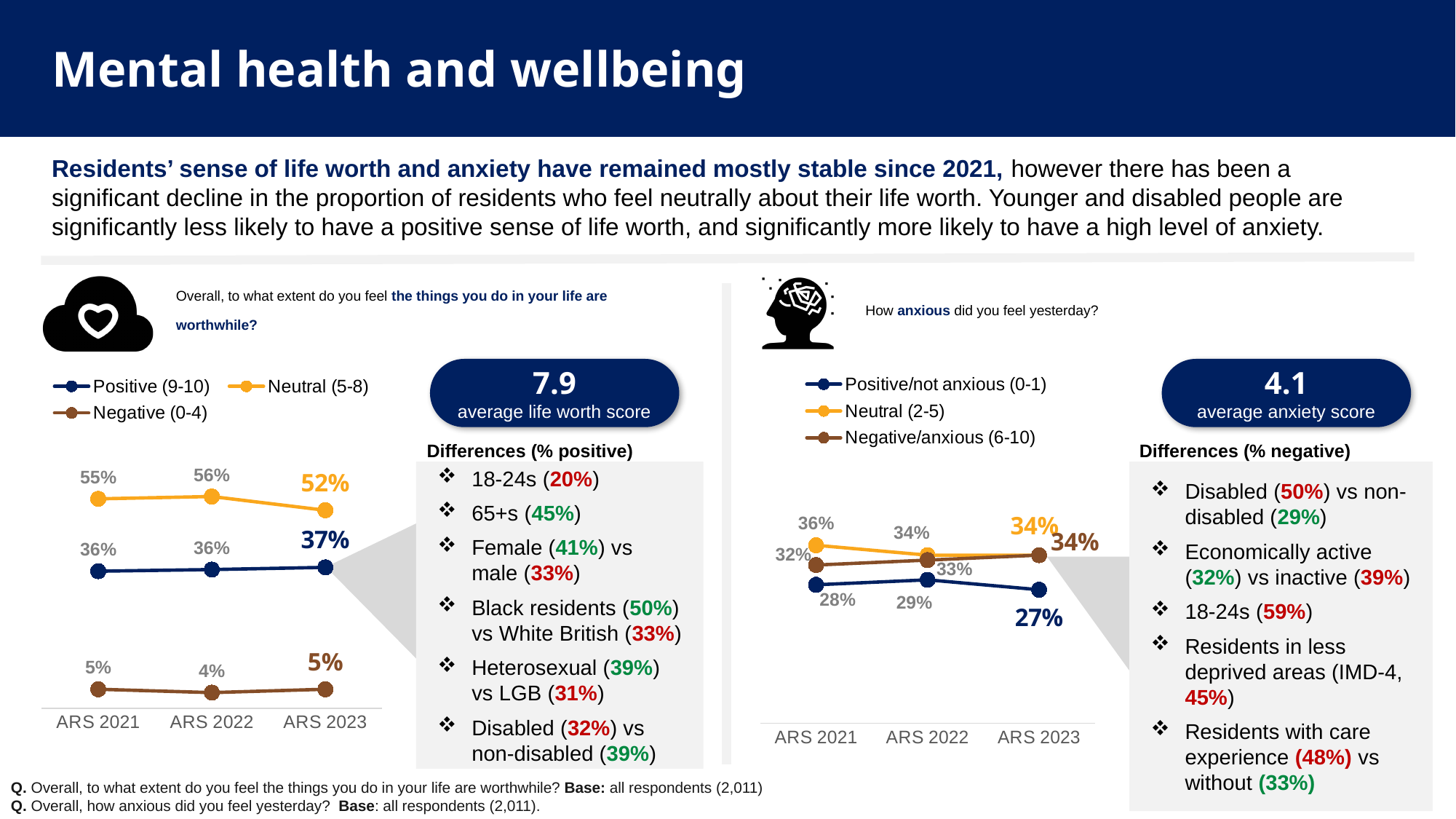
On the left chart (life worth), which series has the highest value in ARS 2023? Neutral (5-8) On the right chart (anxiety), what is the value for Negative/anxious (6-10) in ARS 2023? 34% On the left chart (life worth), what is the difference between the Neutral (5-8) and Positive (9-10) values in ARS 2023? 15 percentage points On the left chart (life worth), how many series does the legend list? 3 On the left chart (life worth), what is the value for Neutral (5-8) in ARS 2023? 52% On the left chart (life worth), what is the value for Negative (0-4) in ARS 2022? 4% On the left chart (life worth), what is the value for Positive (9-10) in ARS 2021? 36% On the left chart (life worth), what kind of chart is it? Line chart On the right chart (anxiety), what is the value for Positive/not anxious (0-1) in ARS 2021? 28% On the right chart (anxiety), how many survey years are shown on the x axis? 3 On the right chart (anxiety), which series has the lowest value in ARS 2023? Positive/not anxious (0-1) On the right chart (anxiety), does the Neutral (2-5) series rise or fall from ARS 2021 to ARS 2023? Fall